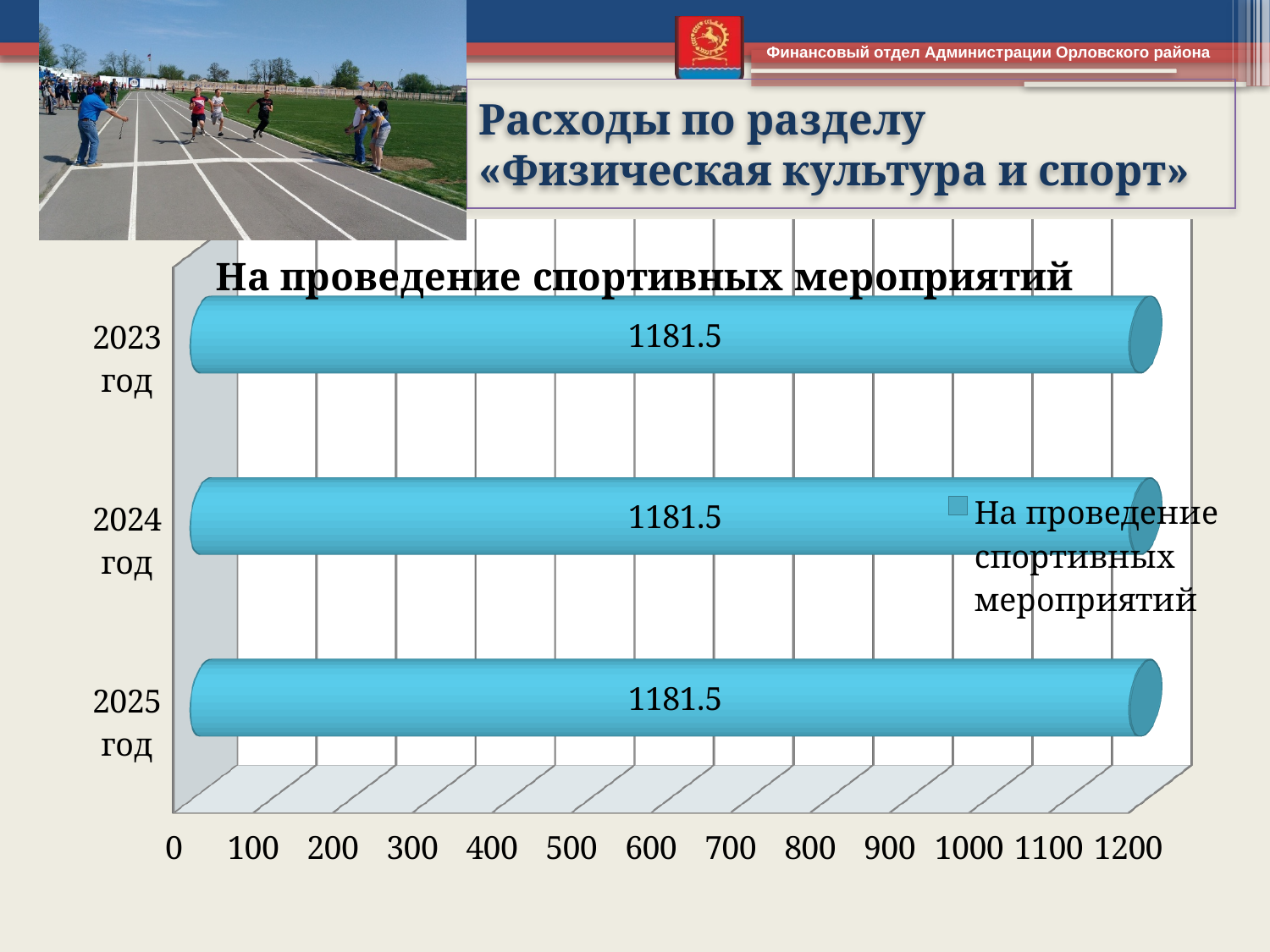
Is the value for 2024 год greater or less than 1000? greater What is the value for 2025 год? 1181.5 What is the difference between the values for 2023 год and 2025 год? 0 What is the value for 2024 год? 1181.5 What is the title of the chart? На проведение спортивных мероприятий How many categories are shown in the chart? 3 How many series does the legend list? 1 Do the values rise, fall or stay the same from 2023 год to 2025 год? stay the same Is the value for 2025 год greater or less than 1200? less What is the value for 2023 год? 1181.5 What kind of chart is shown on the slide? bar chart What is the name of the series listed in the legend? На проведение спортивных мероприятий